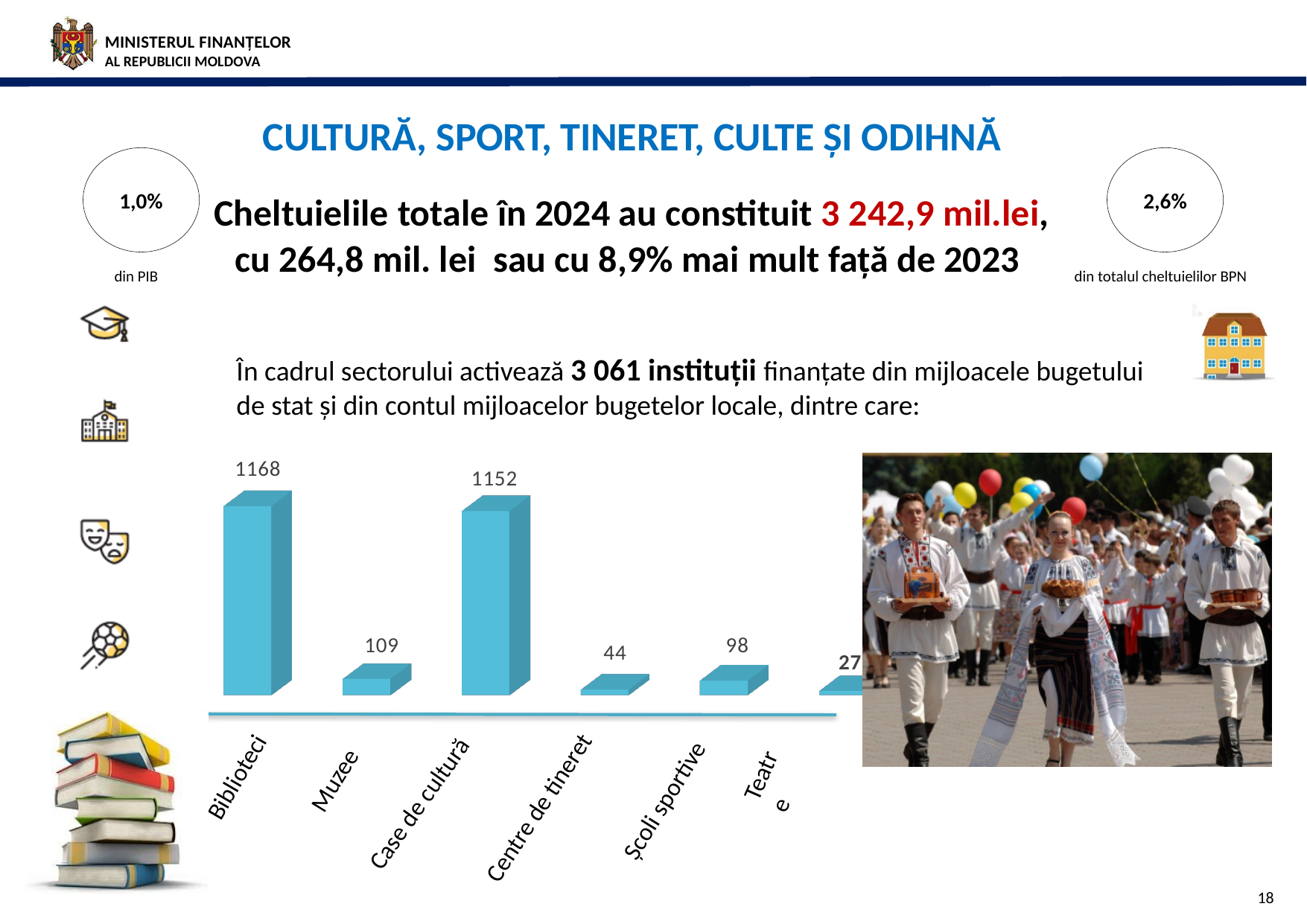
Which is larger, the value for Muzee or the value for Centre de tineret? Muzee What is the difference between the values for Biblioteci and Case de cultură? 16 What is the value for Centre de tineret? 44 What is the value for Muzee? 109 What kind of chart is shown on the slide? Bar chart What is the value for Școli sportive? 98 How many categories are shown in the chart? 6 What is the value for Case de cultură? 1152 Which category has the highest value? Biblioteci Which is larger, the value for Școli sportive or the value for Case de cultură? Case de cultură What is the value for Biblioteci? 1168 What is the difference between the values for Muzee and Școli sportive? 11